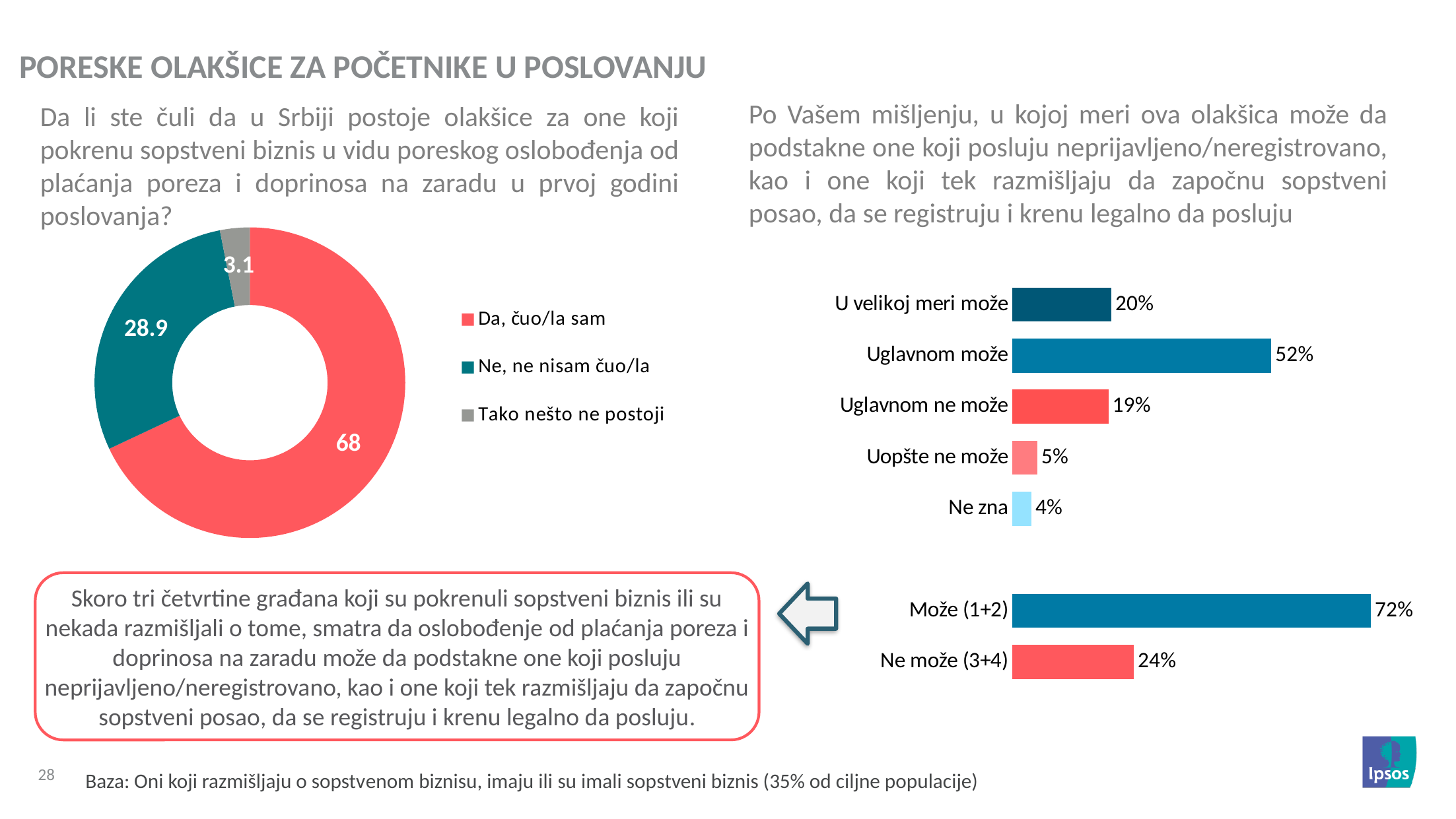
In the bar chart on the right, what is the value for "Uopšte ne može"? 5% In the summary bar chart at the bottom right, what is the value for "Može (1+2)"? 72% In the bar chart on the right, which category has the lowest value? Ne zna In the donut chart on the left, what is the value for "Ne, ne nisam čuo/la"? 28.9 What kind of chart is shown on the left side of the slide? Donut (pie) chart In the donut chart on the left, which category has the smallest slice? Tako nešto ne postoji In the bar chart on the right, what is the value for "Uglavnom može"? 52% In the summary bar chart at the bottom right, what is the difference between "Može (1+2)" and "Ne može (3+4)"? 48% In the bar chart on the right, what is the difference between "U velikoj meri može" and "Uglavnom ne može"? 1% In the donut chart on the left, what is the value for "Da, čuo/la sam"? 68 In the donut chart on the left, how many categories does the legend list? 3 In the bar chart on the right, which category has the highest value? Može (1+2)